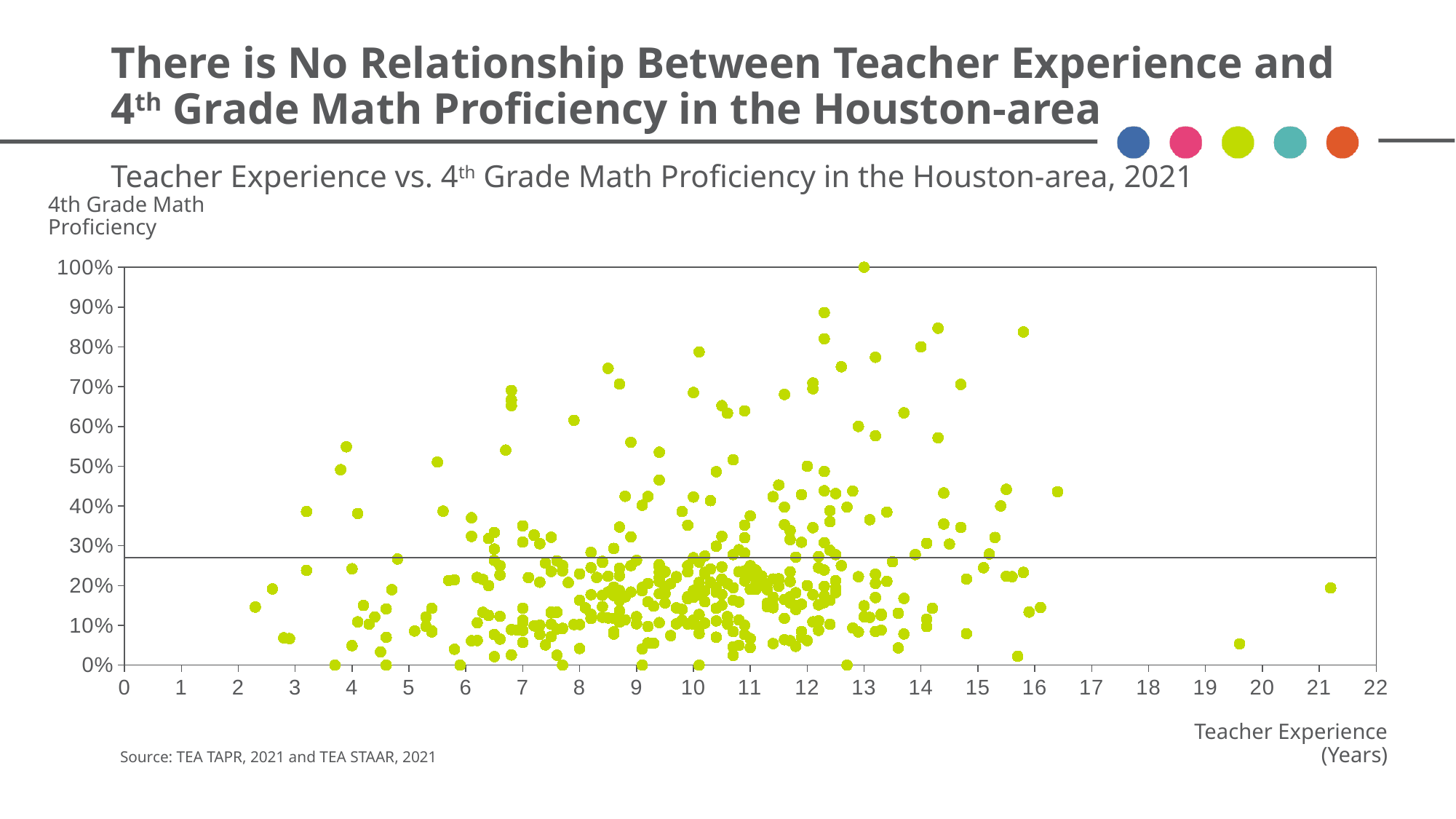
Is the proficiency value of the point at about 21 years of teacher experience greater or less than 30%? less Does 4th Grade Math Proficiency show a clear rising or falling trend as Teacher Experience increases along the x axis? No clear trend What is the highest value shown on the y axis of the chart? 100% What variable is plotted on the x axis of the chart? Teacher Experience (Years) Is the proficiency value of the point at about 19.6 years of teacher experience greater or less than 10%? less What kind of chart is shown on the slide? Scatter plot Is the proficiency value of the point at about 16.4 years of teacher experience greater or less than 40%? greater What is the highest 4th Grade Math Proficiency value reached by any point on the chart? 100% What is the title of the chart? Teacher Experience vs. 4th Grade Math Proficiency in the Houston-area, 2021 What is the highest value shown on the x axis of the chart? 22 What is the source cited for the chart's data? TEA TAPR, 2021 and TEA STAAR, 2021